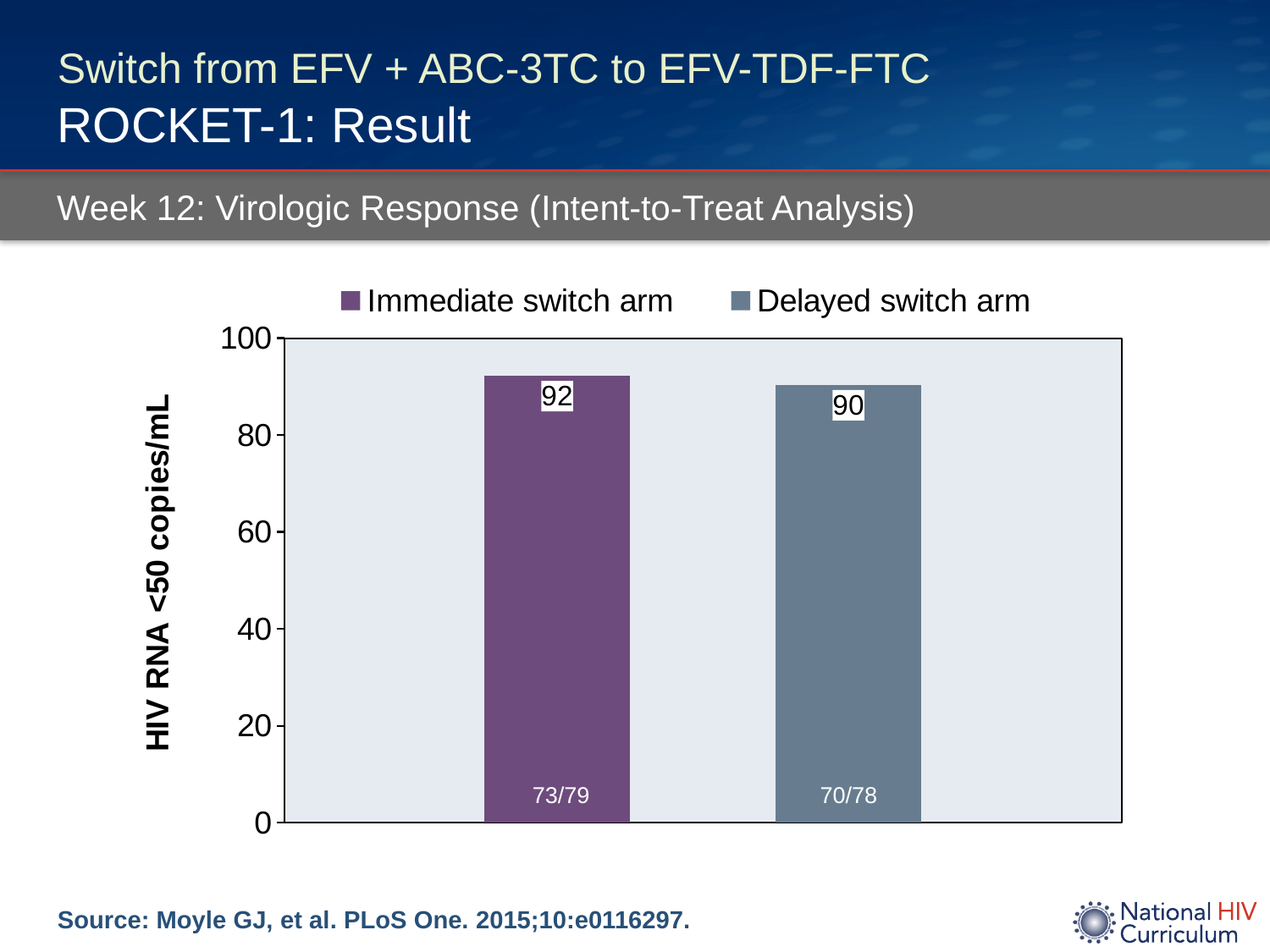
What fraction is printed at the bottom of the Immediate switch arm bar? 73/79 What fraction is printed at the bottom of the Delayed switch arm bar? 70/78 Is the value for the Immediate switch arm greater or less than 80? greater What is the maximum value shown on the y axis? 100 What is the y-axis label? HIV RNA <50 copies/mL How many series does the legend list? 2 What is the value for the Delayed switch arm? 90 Which arm has the lower value? Delayed switch arm What kind of chart is shown? bar chart What is the value for the Immediate switch arm? 92 What is the difference between the Immediate switch arm and the Delayed switch arm values? 2 Which arm has the higher value? Immediate switch arm